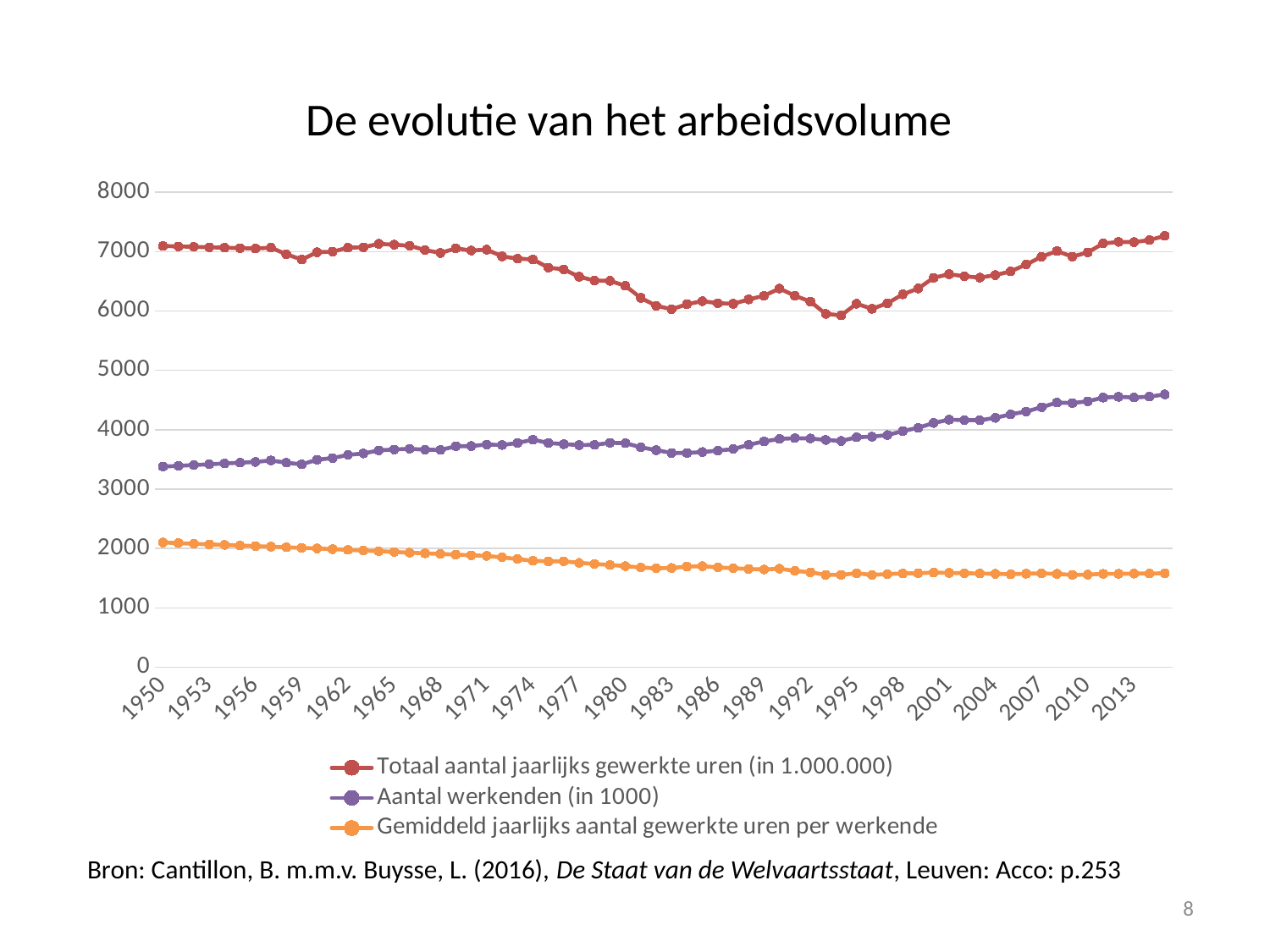
What colour is the line for 'Aantal werkenden (in 1000)'? purple Which series has the lowest values across the whole period? Gemiddeld jaarlijks aantal gewerkte uren per werkende Is the value for 'Aantal werkenden (in 1000)' in 1950 greater or less than 4000? less In 1950, which series has the higher value: 'Totaal aantal jaarlijks gewerkte uren (in 1.000.000)' or 'Aantal werkenden (in 1000)'? Totaal aantal jaarlijks gewerkte uren (in 1.000.000) Is the value for 'Aantal werkenden (in 1000)' in 2013 greater or less than 4000? greater What is the title of the chart? De evolutie van het arbeidsvolume Is the value for 'Totaal aantal jaarlijks gewerkte uren (in 1.000.000)' in 1950 greater or less than 6000? greater Does the series 'Gemiddeld jaarlijks aantal gewerkte uren per werkende' rise or fall from 1950 to 2013? fall What kind of chart is shown on the slide? line chart How many series does the legend list? 3 Does the series 'Aantal werkenden (in 1000)' rise or fall overall from 1950 to 2013? rise